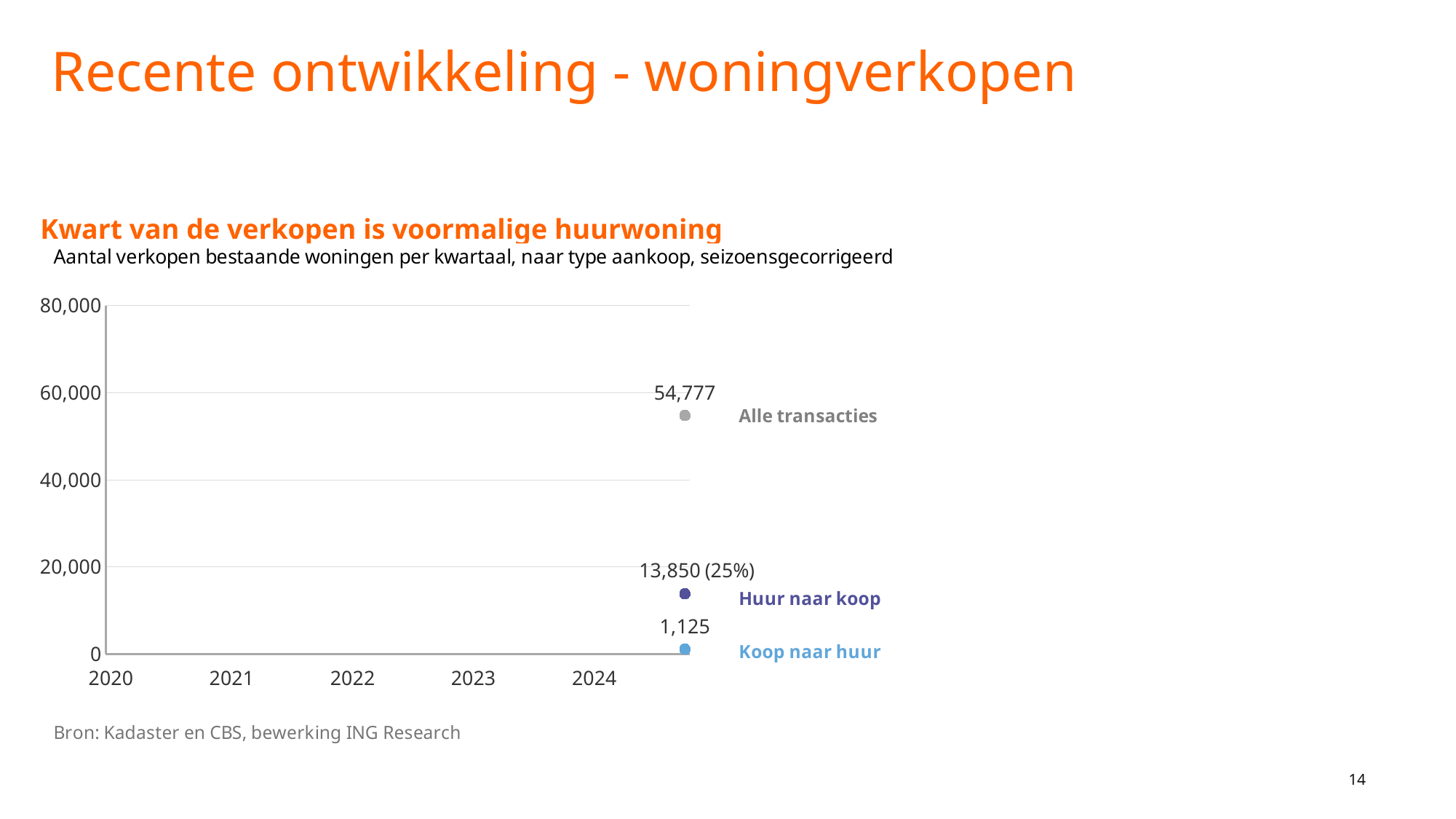
Which series has the lowest value? Koop naar huur What is the chart's title? Kwart van de verkopen is voormalige huurwoning What is the value shown for Alle transacties? 54,777 What percentage is printed next to the Huur naar koop value? 25% What is the value shown for Huur naar koop? 13,850 What is the difference between the Huur naar koop value and the Koop naar huur value? 12,725 Which is larger, the value for Huur naar koop or the value for Koop naar huur? Huur naar koop Is the value for Alle transacties greater or less than 60,000? less How many series are labelled on the chart? 3 Which series has the highest value? Alle transacties What is the value shown for Koop naar huur? 1,125 What is the difference between the Alle transacties value and the Huur naar koop value? 40,927